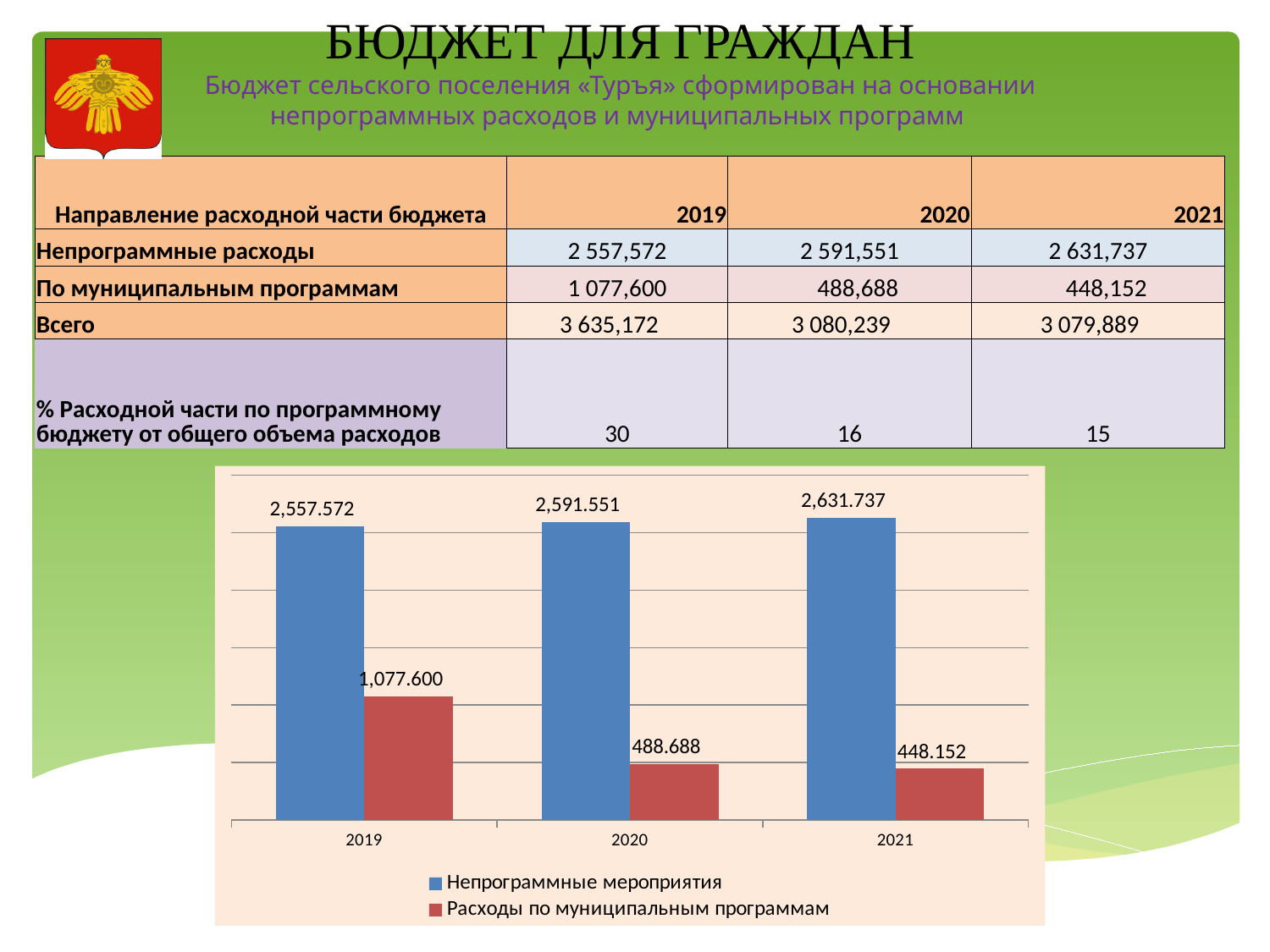
In 2020, which series has the larger value in the chart: Непрограммные мероприятия or Расходы по муниципальным программам? Непрограммные мероприятия What is the value of Расходы по муниципальным программам for 2021 in the chart? 448.152 What is the value of Расходы по муниципальным программам for 2020 in the chart? 488.688 What is the difference between Расходы по муниципальным программам in 2019 and in 2020 in the chart? 588.912 How many series does the chart legend list? 2 What kind of chart is shown on the slide? Bar chart In which year is Расходы по муниципальным программам highest in the chart? 2019 In which year is Расходы по муниципальным программам lowest in the chart? 2021 How many years are shown on the x axis of the chart? 3 What is the difference between Непрограммные мероприятия in 2021 and in 2019 in the chart? 74.165 What is the value of Непрограммные мероприятия for 2019 in the chart? 2,557.572 What is the value of Непрограммные мероприятия for 2021 in the chart? 2,631.737